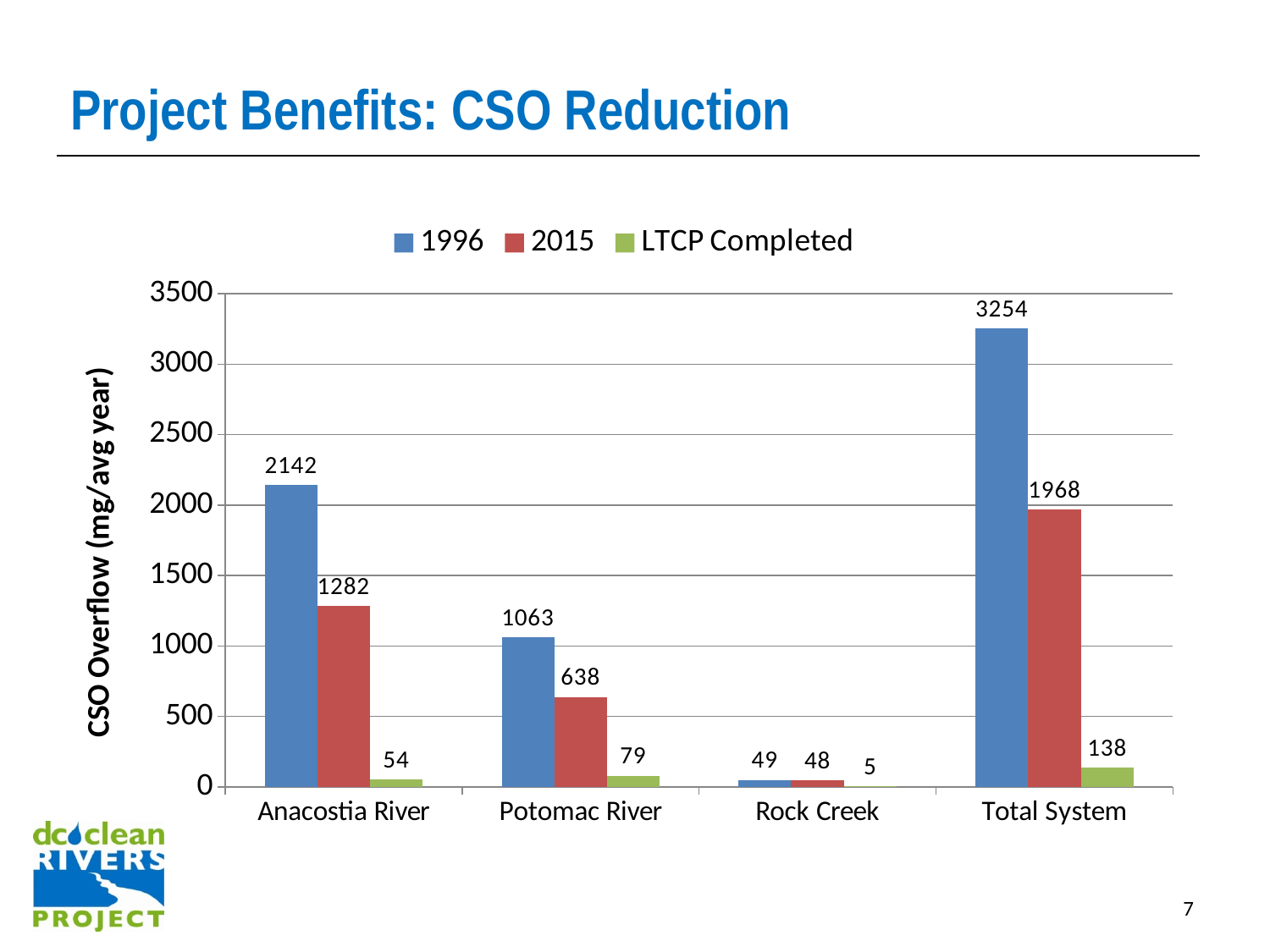
What is the 1996 value for Anacostia River? 2142 How many series does the legend list? 3 What is the difference between the 1996 and 2015 values for Anacostia River? 860 What is the 2015 value for Potomac River? 638 How many categories are shown on the x axis? 4 What is the LTCP Completed value for Rock Creek? 5 Which is larger, the 2015 value for Anacostia River or the 1996 value for Potomac River? 2015 value for Anacostia River What kind of chart is shown on the slide? Bar chart What is the y-axis label of the chart? CSO Overflow (mg/avg year) Which category has the lowest 2015 value? Rock Creek Which category has the highest 1996 value? Total System What is the LTCP Completed value for Total System? 138